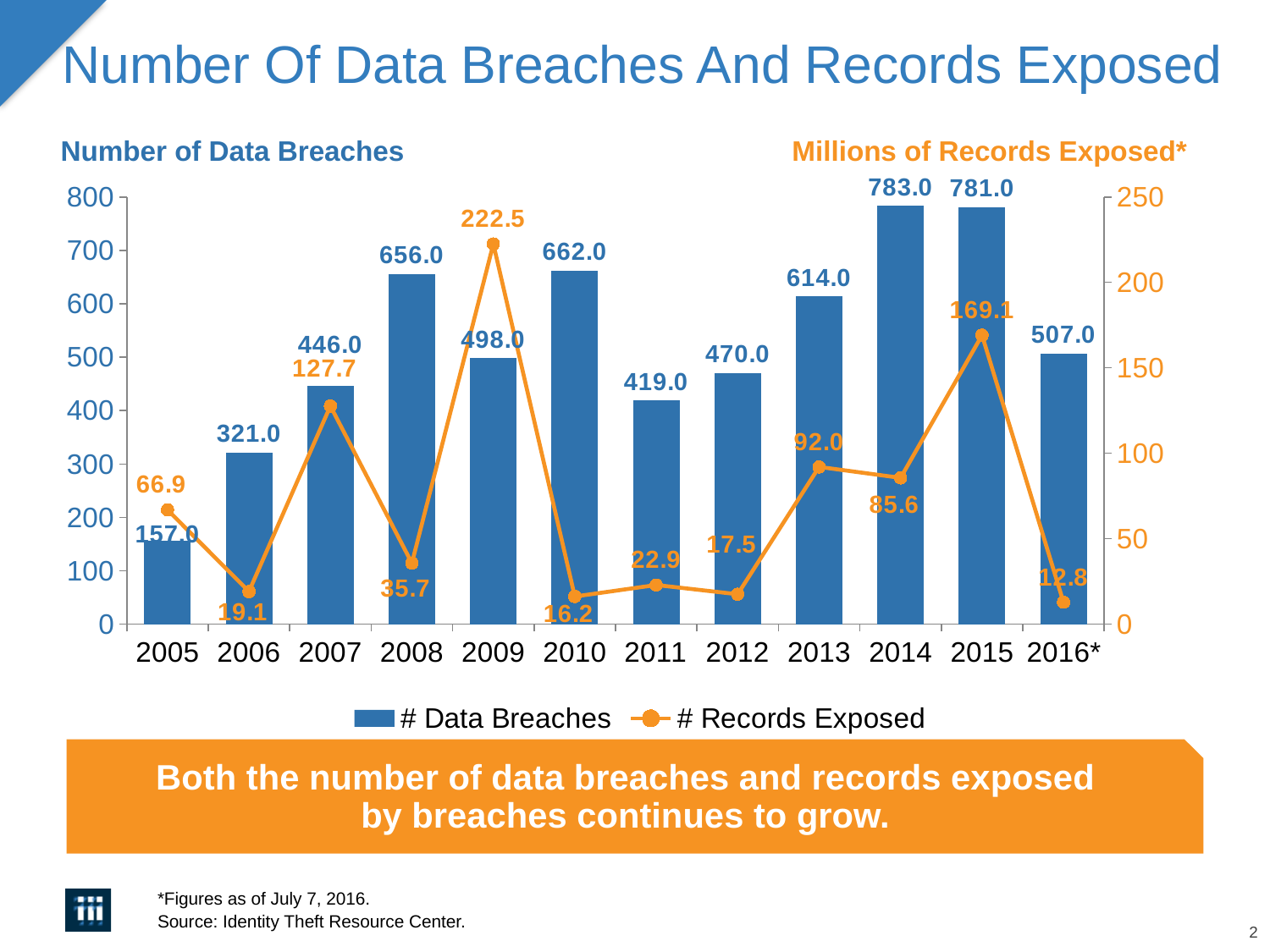
How many years are shown on the x axis? 12 What is the value for # Records Exposed in 2016*? 12.8 How many series does the legend list? 2 Which year has the highest number of data breaches? 2014 Which year has the highest number of records exposed? 2009 What is the difference in the number of data breaches between 2010 and 2009? 164.0 Which year had more data breaches, 2008 or 2013? 2008 Which year has the lowest number of data breaches? 2005 What is the difference in millions of records exposed between 2009 and 2015? 53.4 What kind of chart is used to show # Data Breaches? Bar chart How many data breaches were recorded in 2014? 783.0 How many millions of records were exposed in 2009? 222.5